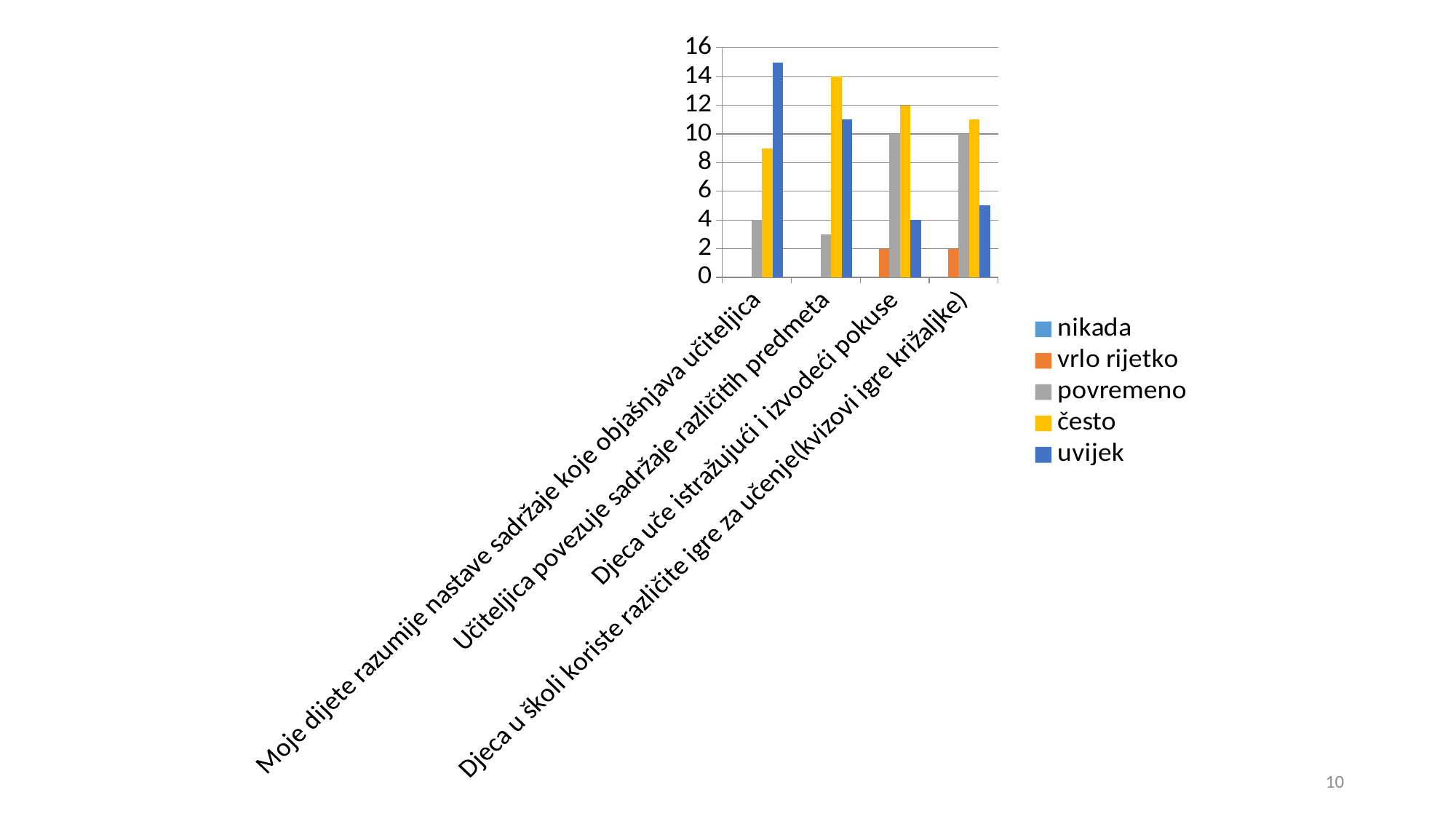
Which series has the highest value for 'Moje dijete razumije nastave sadržaje koje objašnjava učiteljica'? uvijek For 'Djeca uče istražujući i izvodeći pokuse', which is larger: 'često' or 'uvijek'? često What is the value of 'povremeno' for 'Djeca u školi koriste različite igre za učenje(kvizovi igre križaljke)'? 10 What is the value of 'često' for 'Djeca uče istražujući i izvodeći pokuse'? 12 What is the value of 'vrlo rijetko' for 'Djeca uče istražujući i izvodeći pokuse'? 2 What is the value of 'povremeno' for 'Moje dijete razumije nastave sadržaje koje objašnjava učiteljica'? 4 Is the value of 'uvijek' for 'Djeca u školi koriste različite igre za učenje(kvizovi igre križaljke)' greater or less than 6? less What is the value of 'često' for 'Učiteljica povezuje sadržaje različitih predmeta'? 14 How many series does the legend list? 5 Is the value of 'uvijek' for 'Moje dijete razumije nastave sadržaje koje objašnjava učiteljica' greater or less than 14? greater What kind of chart is shown on the slide? bar chart How many categories are shown on the x axis? 4